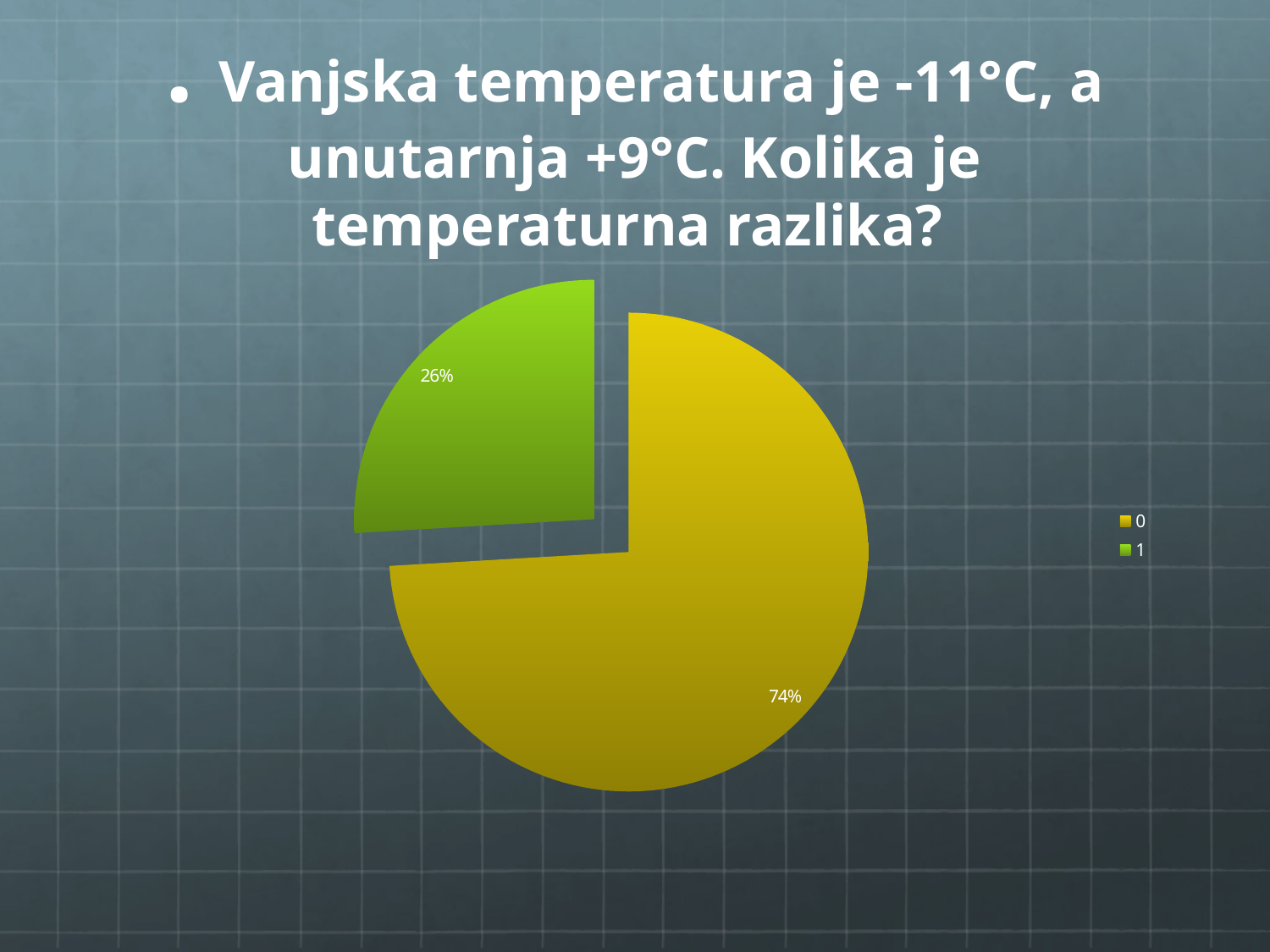
What share of the pie does the slice labelled 0 take? 74% What kind of chart is shown on the slide? pie chart What colour is the slice labelled 0 in the pie chart? yellow Which slice of the pie is the largest? 0 What is the difference in percentage points between the slice for 0 and the slice for 1? 48 How many slices does the pie chart have? 2 What colour is the slice labelled 1 in the pie chart? green Which is larger, the slice for 0 or the slice for 1? 0 Which slice of the pie is the smallest? 1 What share of the pie does the slice labelled 1 take? 26% How many entries does the legend list? 2